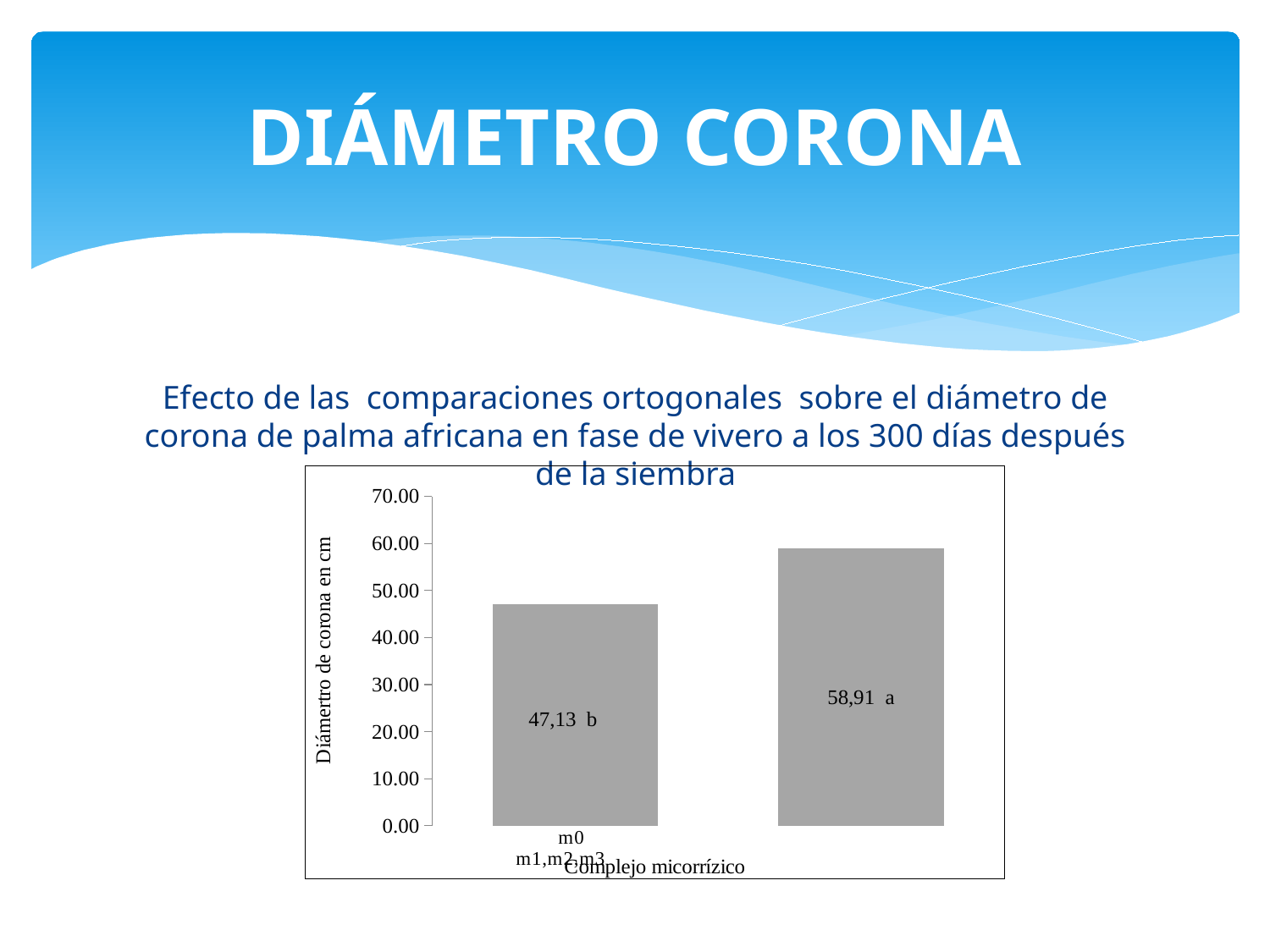
Is the value of the right-hand bar greater or less than 50.00? greater Is the value for m0 greater or less than 50.00? less What value is printed on the right-hand bar of the chart? 58,91 a What is the title of the vertical axis? Diámertro de corona en cm What value is printed on the bar for m0? 47,13 b How many bars are plotted in the chart? 2 What is the highest tick value shown on the vertical axis? 70.00 What kind of chart is shown on the slide? bar chart What is the title of the horizontal axis? Complejo micorrízico Which bar is taller, the m0 bar or the right-hand bar? the right-hand bar Which bar has the lowest value? m0 What is the difference between the two bar values, 58,91 and 47,13? 11,78